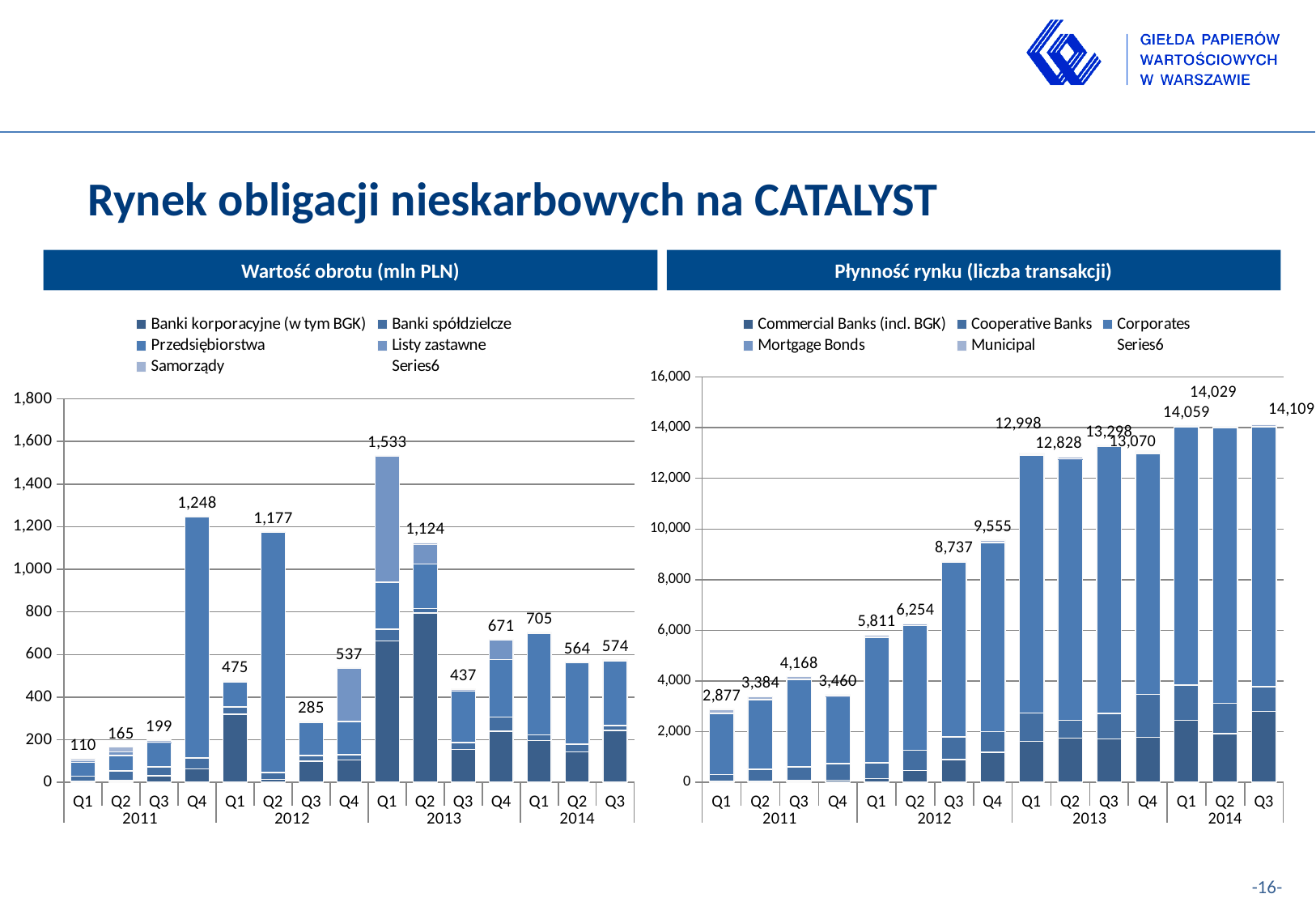
On the 'Płynność rynku (liczba transakcji)' chart, what is the total number of transactions for Q3 2012? 8,737 On the 'Wartość obrotu (mln PLN)' chart, which quarter has the lowest total? Q1 2011 On the 'Płynność rynku (liczba transakcji)' chart, what is the difference between the totals for Q2 2012 and Q1 2012? 443 On the 'Płynność rynku (liczba transakcji)' chart, what is the total for Q1 2011? 2,877 On the 'Wartość obrotu (mln PLN)' chart, what is the total value for Q4 2011? 1,248 What type of chart is the 'Wartość obrotu (mln PLN)' chart? Stacked bar chart How many quarterly bars are shown on the 'Płynność rynku (liczba transakcji)' chart? 15 On the 'Płynność rynku (liczba transakcji)' chart, which quarter has the highest total? Q3 2014 On the 'Wartość obrotu (mln PLN)' chart, which is larger, the total for Q2 2012 or Q2 2013? Q2 2012 On the 'Wartość obrotu (mln PLN)' chart, what is the total value for Q1 2013? 1,533 On the 'Wartość obrotu (mln PLN)' chart, which quarter has the highest total? Q1 2013 On the 'Wartość obrotu (mln PLN)' chart, what is the difference between the totals for Q1 2014 and Q2 2014? 141